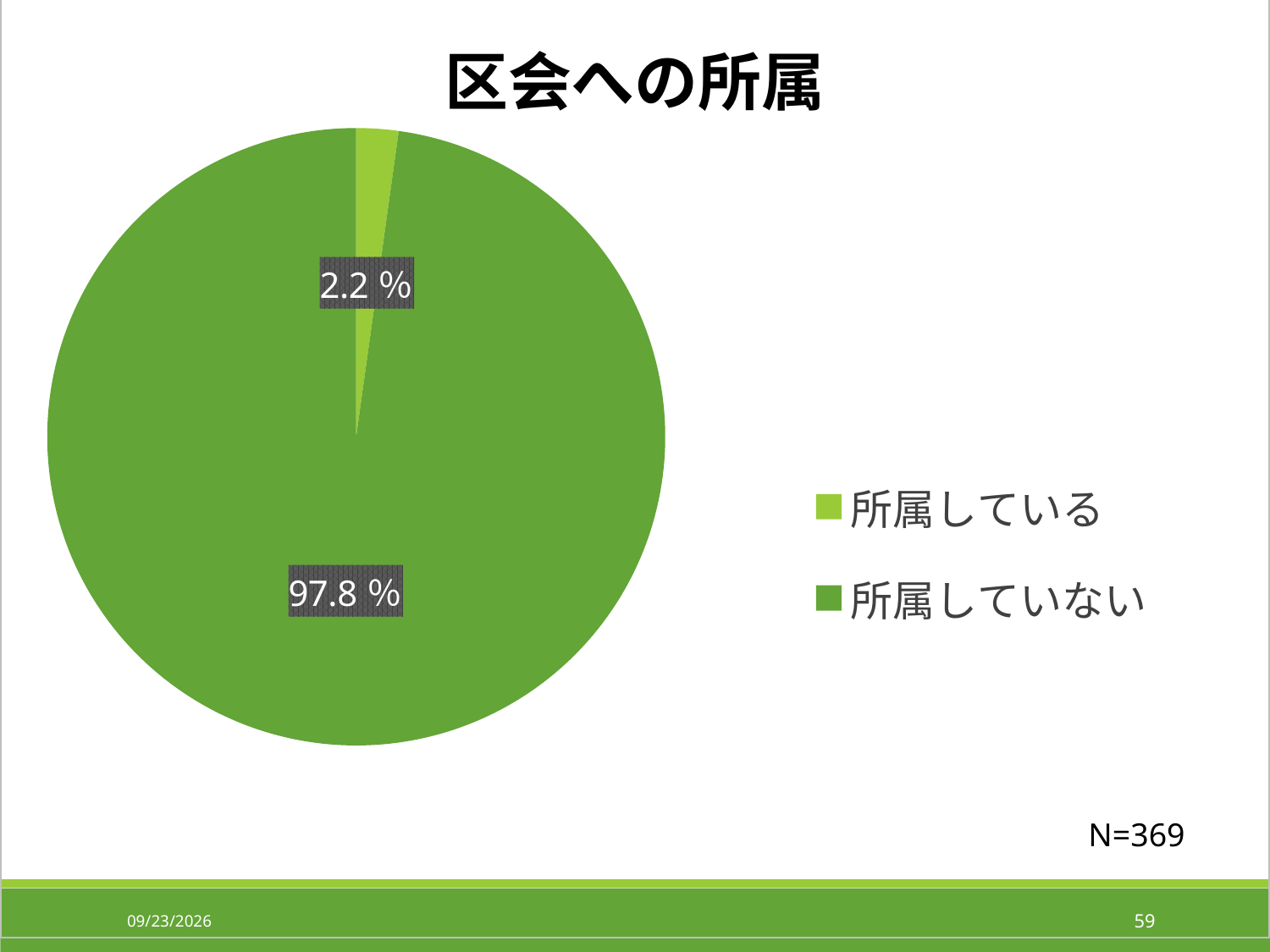
Which category has the largest share of the pie? 所属していない What is the difference in percentage points between 所属していない and 所属している? 95.6 Which category has the smallest share of the pie? 所属している What is the chart's title? 区会への所属 What percentage is shown for 所属していない? 97.8 % What kind of chart is shown on the slide? pie chart How many entries does the legend list? 2 Which is larger, the share for 所属している or the share for 所属していない? 所属していない What share of the pie does 所属している represent? 2.2 % What is the sample size (N) shown on the slide? 369 What percentage is shown for 所属している? 2.2 % How many slices does the pie chart have? 2